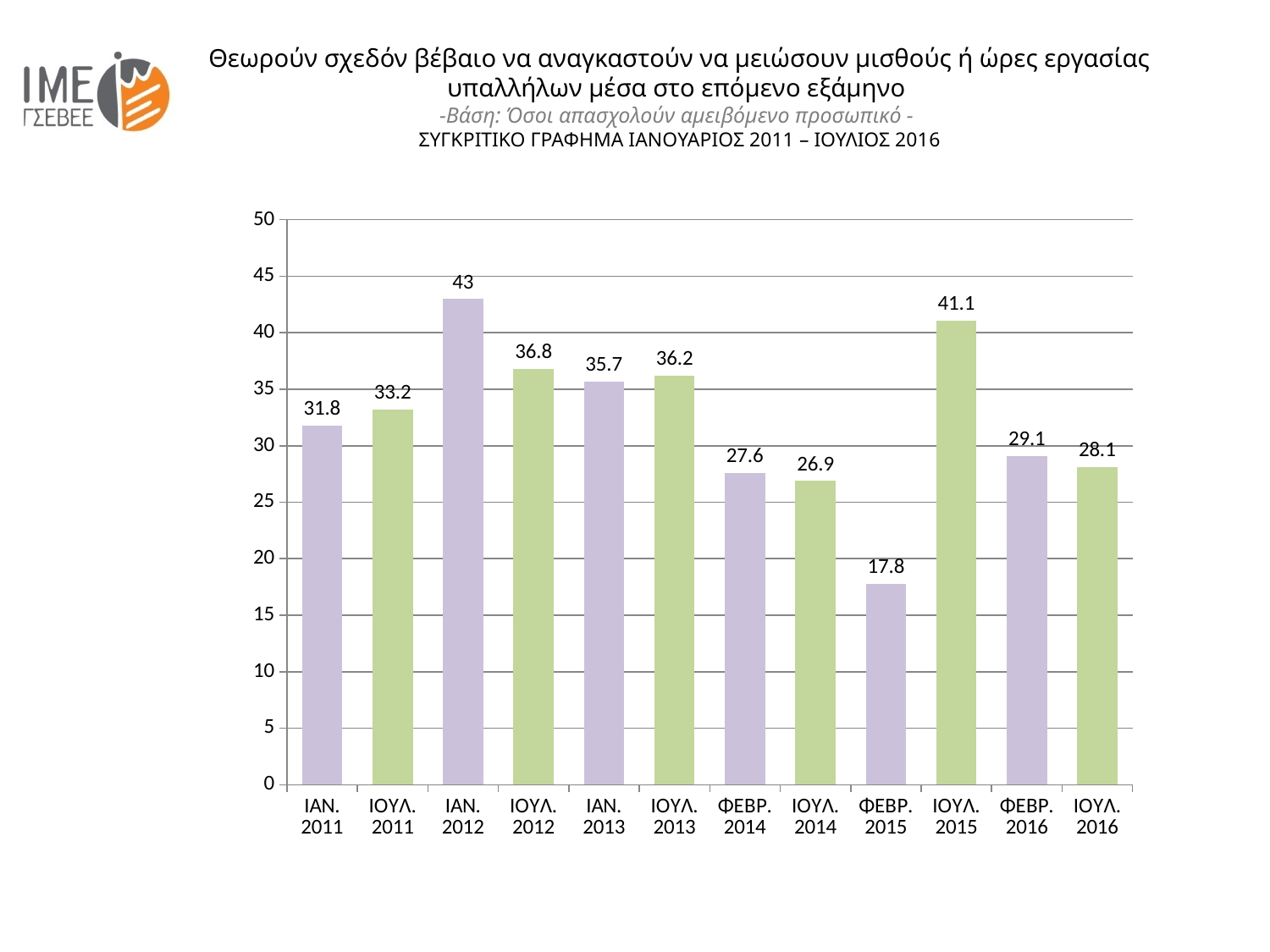
What is the difference between the values for ΙΟΥΛ. 2015 and ΦΕΒΡ. 2015? 23.3 What is the value for ΙΑΝ. 2012? 43 How many periods are shown on the x axis? 12 Which period has the lowest value? ΦΕΒΡ. 2015 What kind of chart is shown on the slide? bar chart Is the value for ΙΟΥΛ. 2014 greater or less than 30? less What is the value for ΙΟΥΛ. 2016? 28.1 What is the value for ΦΕΒΡ. 2015? 17.8 Which period has the highest value? ΙΑΝ. 2012 Do the values rise or fall from ΙΟΥΛ. 2013 to ΦΕΒΡ. 2015? fall What is the difference between the values for ΙΑΝ. 2011 and ΙΟΥΛ. 2011? 1.4 Which is larger, the value for ΙΟΥΛ. 2012 or the value for ΙΟΥΛ. 2013? ΙΟΥΛ. 2012